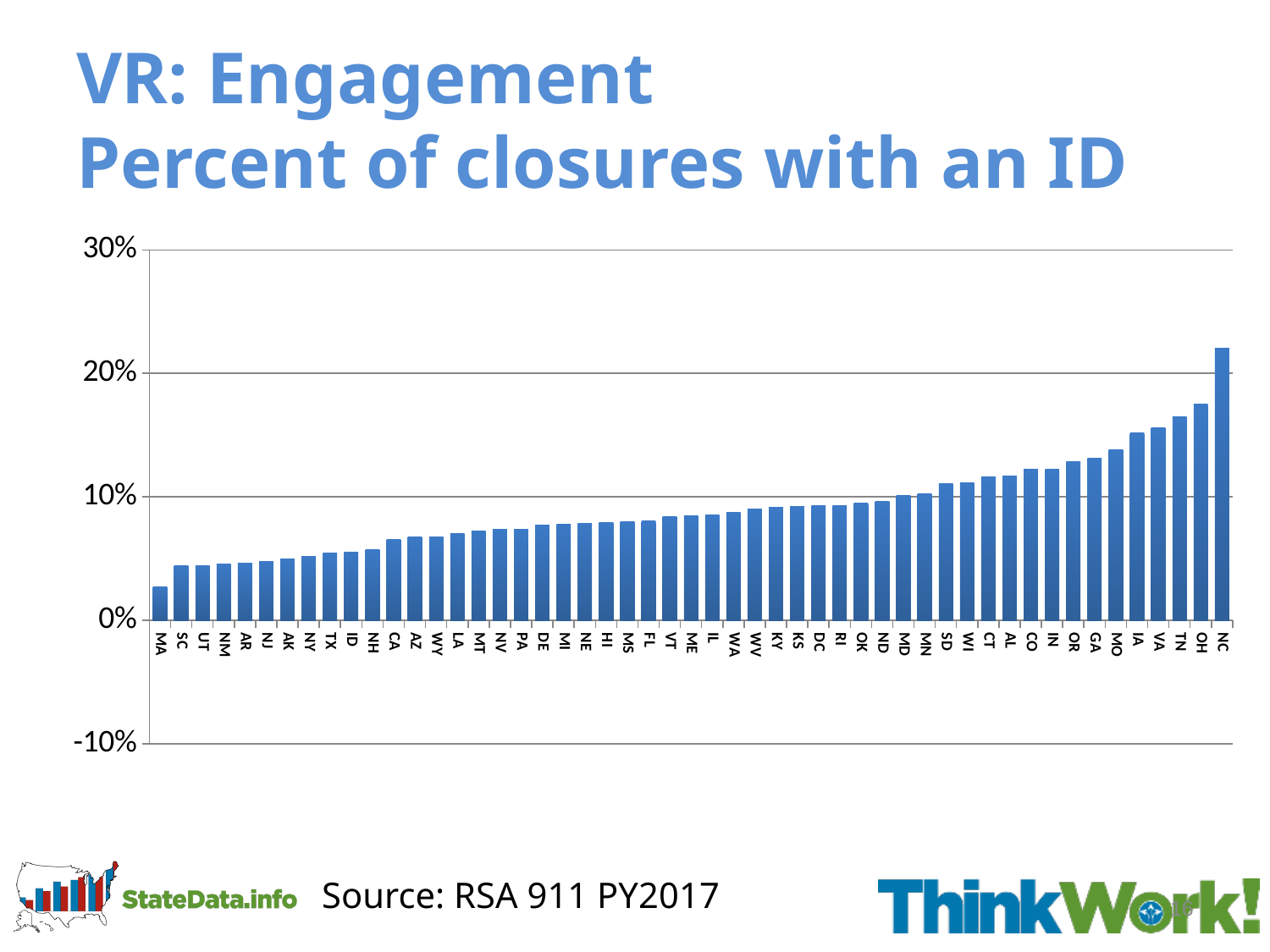
Which state has the highest percent of closures with an ID? NC Is the value for MA greater or less than 10%? less Which has a higher value, NC or OH? NC Is the value for NC greater or less than 20%? greater What is the highest value shown on the vertical axis? 30% Which state has the lowest percent of closures with an ID? MA What kind of chart is shown on the slide? bar chart How many states (bars) are shown in the chart? 51 Do the values rise or fall moving from left to right along the x axis? rise Which has a higher value, TX or VA? VA Is the value for CO greater or less than 10%? greater